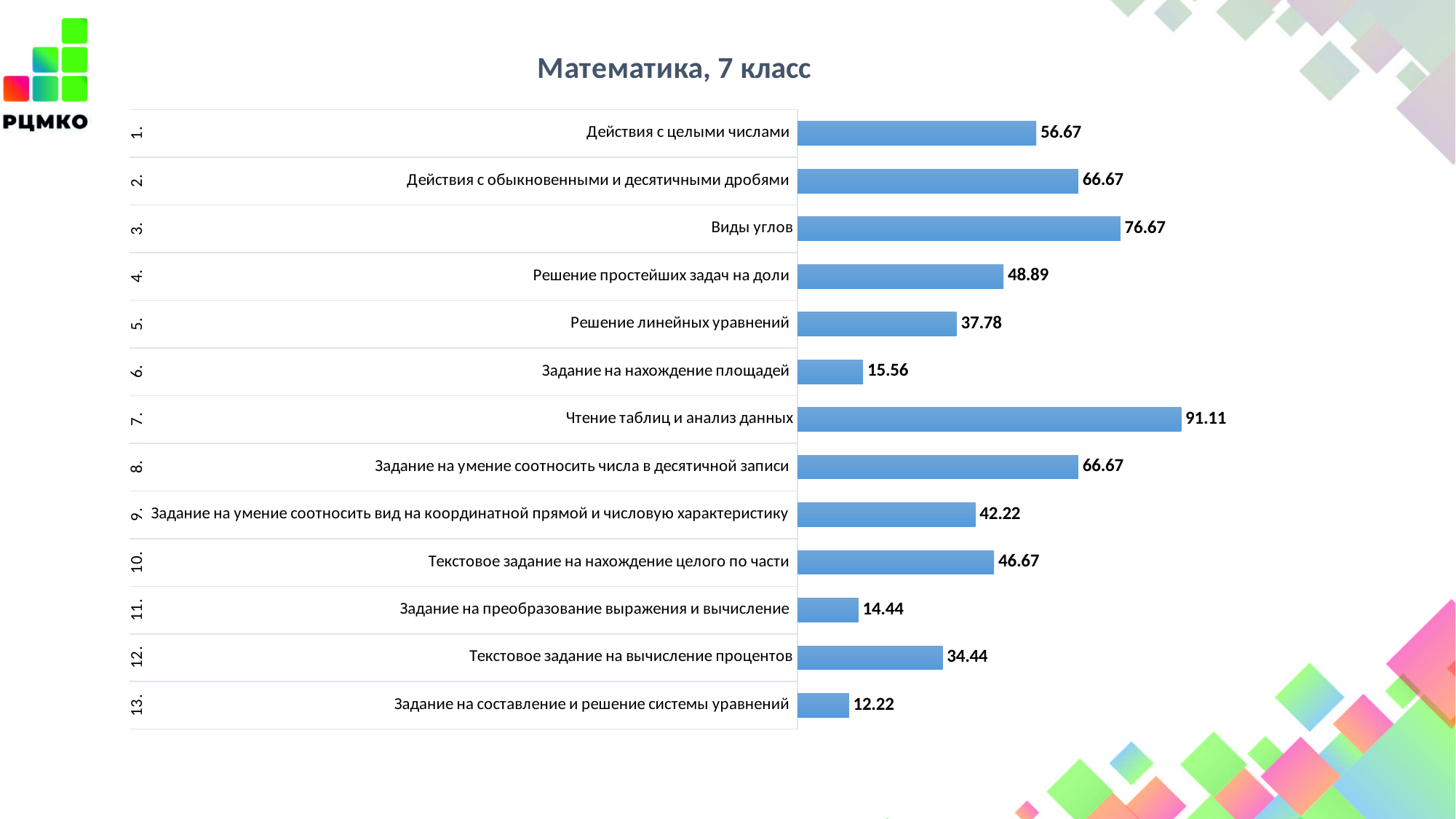
What is the difference between the values for "Задание на нахождение площадей" and "Задание на преобразование выражения и вычисление"? 1.12 What is the title of the chart? Математика, 7 класс What is the value for "Чтение таблиц и анализ данных"? 91.11 What is the value for "Решение линейных уравнений"? 37.78 What is the value for "Текстовое задание на вычисление процентов"? 34.44 What kind of chart is shown on the slide? Bar chart What is the difference between the values for "Виды углов" and "Действия с целыми числами"? 20 What is the value for "Виды углов"? 76.67 Which category has the lowest value? Задание на составление и решение системы уравнений Which is larger: the value for "Решение простейших задач на доли" or the value for "Текстовое задание на нахождение целого по части"? Решение простейших задач на доли How many categories are shown in the chart? 13 Which category has the highest value? Чтение таблиц и анализ данных